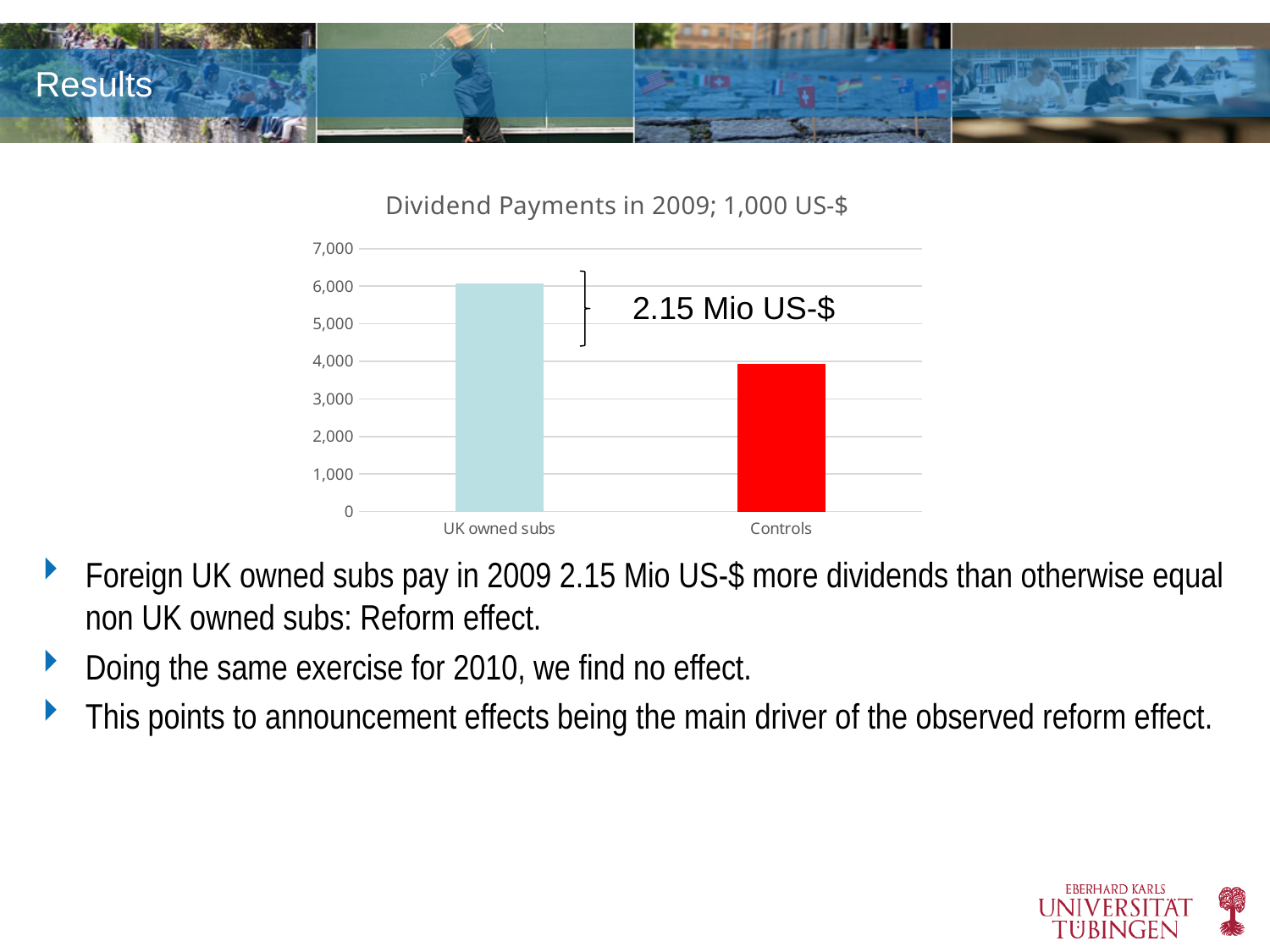
Which is larger, the value for UK owned subs or the value for Controls? UK owned subs Which category has the highest dividend payments in the chart? UK owned subs Is the value for Controls greater or less than 5,000? less What difference between the two bars is annotated on the chart? 2.15 Mio US-$ What is the title of the chart? Dividend Payments in 2009; 1,000 US-$ Is the value for Controls greater or less than 3,000? greater Is the value for UK owned subs greater or less than 7,000? less What kind of chart is shown on the slide? bar chart Which category has the lowest dividend payments in the chart? Controls How many categories are plotted in the chart? 2